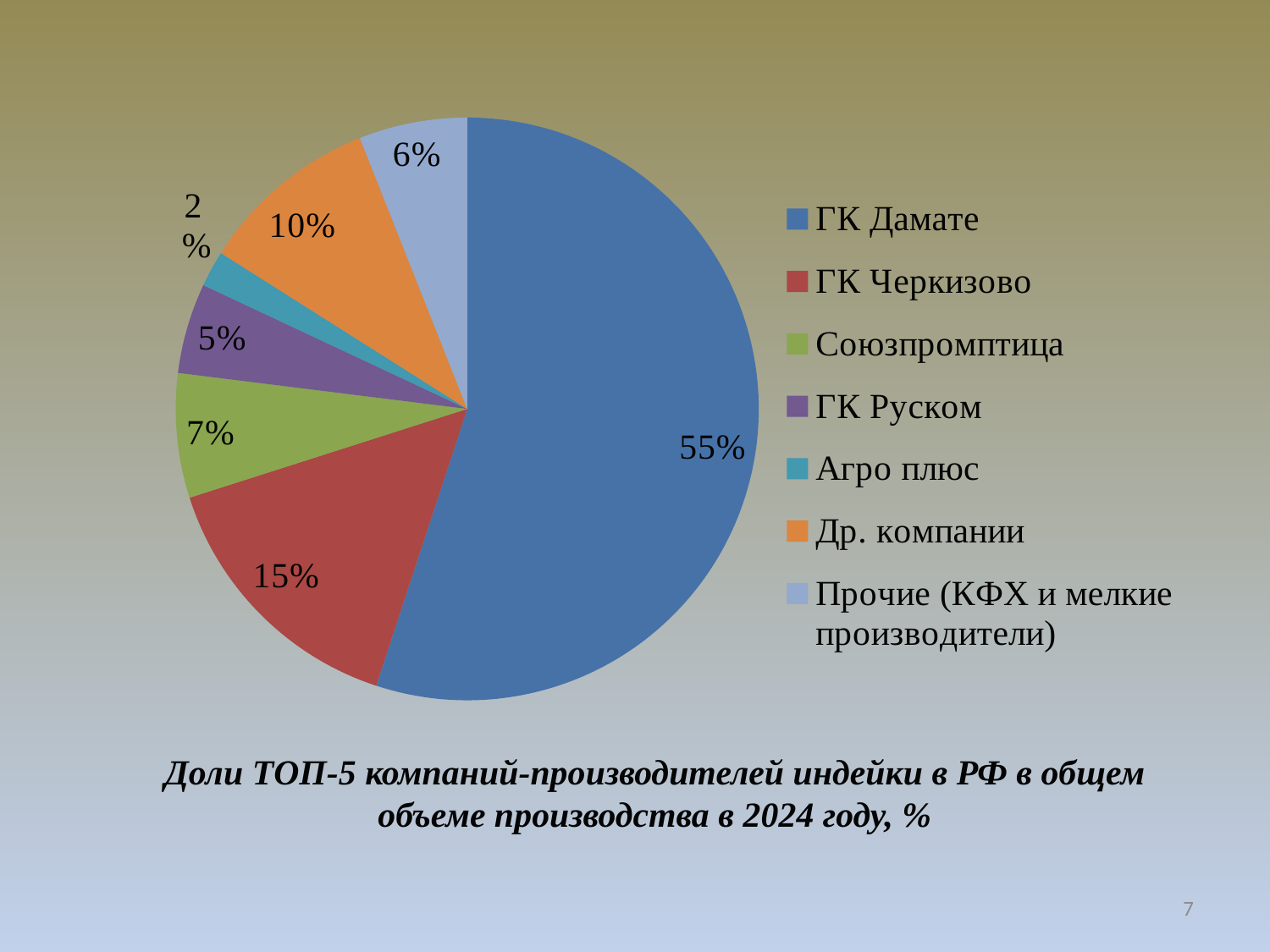
Which category has the smallest slice of the pie? Агро плюс What type of chart is shown on the slide? Pie chart What share does ГК Черкизово hold in the pie chart? 15% What colour is the slice for ГК Черкизово? Red What is the difference between the shares of ГК Дамате and ГК Черкизово? 40% Which is larger, the share of Др. компании or the share of ГК Руском? Др. компании Which company has the largest slice of the pie? ГК Дамате What share is shown for Агро плюс? 2% What share does ГК Дамате hold in the pie chart? 55% What share is shown for Союзпромптица? 7% What share is shown for Прочие (КФХ и мелкие производители)? 6% How many slices does the pie chart have? 7